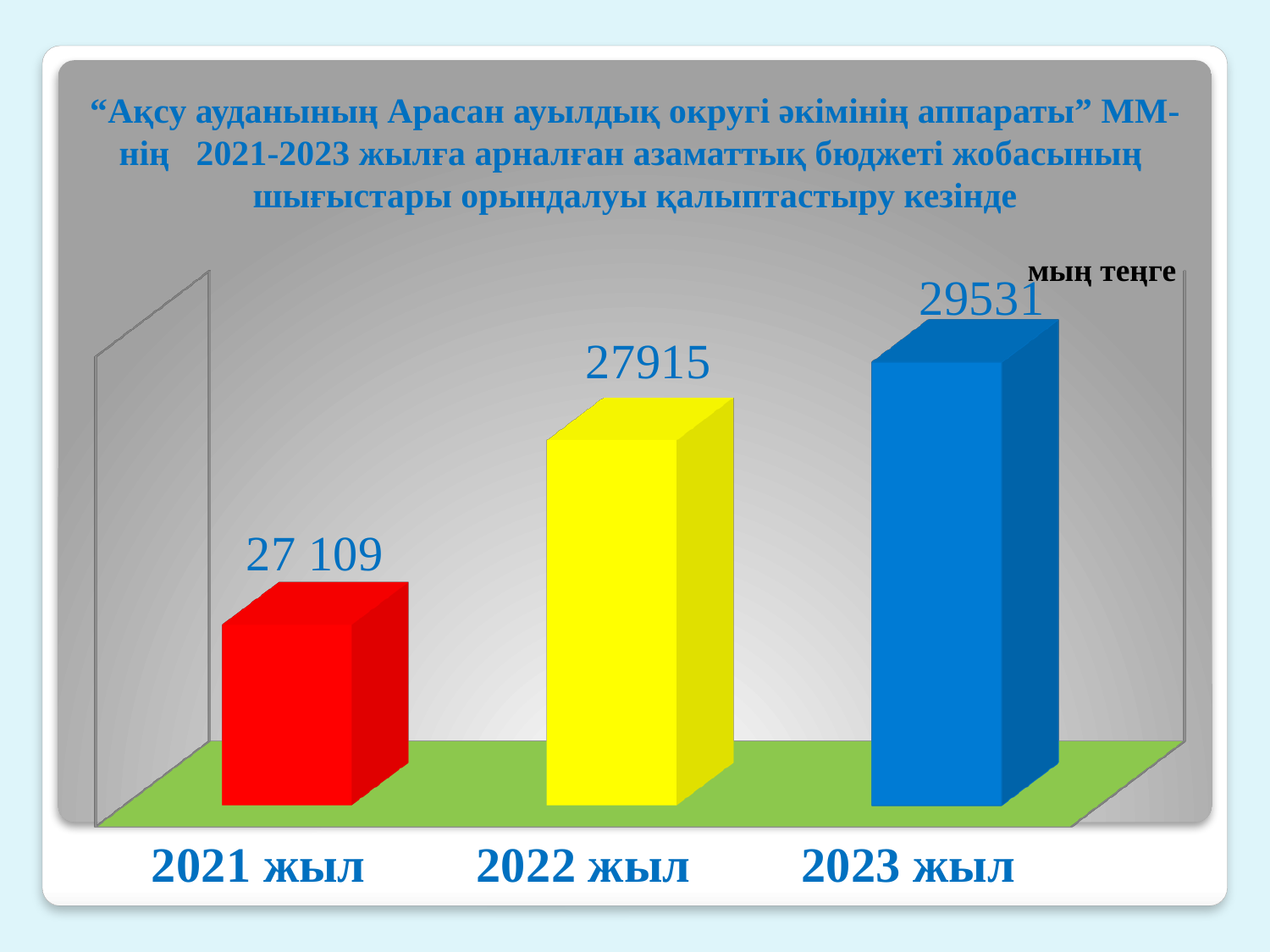
What is the value for 2021 жыл? 27 109 How many bars are shown in the chart? 3 What is the value for 2023 жыл? 29531 Which year has the lowest value? 2021 жыл What unit is indicated in the top right corner of the chart? мың теңге What is the value for 2022 жыл? 27915 Which year has the highest value? 2023 жыл Which is larger, the value for 2022 жыл or 2021 жыл? 2022 жыл Do the values rise or fall from 2021 жыл to 2023 жыл? rise What is the difference between the values for 2022 жыл and 2021 жыл? 806 What is the difference between the values for 2023 жыл and 2022 жыл? 1616 What kind of chart is shown on the slide? bar chart